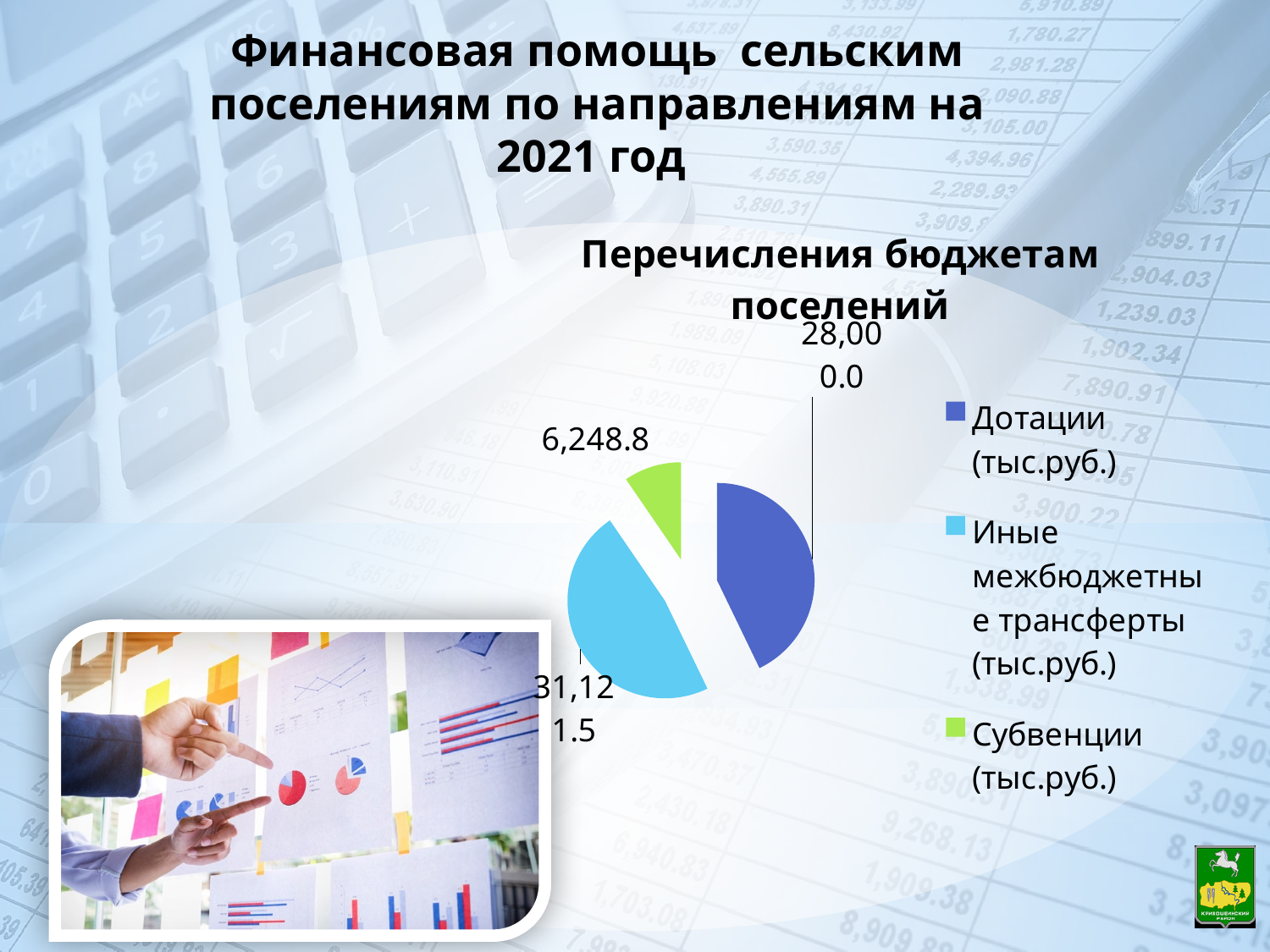
What is the title of the chart? Перечисления бюджетам поселений Which is larger, Дотации or Субвенции? Дотации What is the difference between Иные межбюджетные трансферты and Дотации? 3,121.5 What kind of chart is shown on the slide? Pie chart Which category has the largest slice of the pie? Иные межбюджетные трансферты (тыс.руб.) What is the value for Дотации (тыс.руб.)? 28,000.0 What is the value for Иные межбюджетные трансферты (тыс.руб.)? 31,121.5 How many slices does the pie chart have? 3 What colour is the Субвенции slice? Green What is the value for Субвенции (тыс.руб.)? 6,248.8 How many entries does the chart legend list? 3 Which category has the smallest slice of the pie? Субвенции (тыс.руб.)